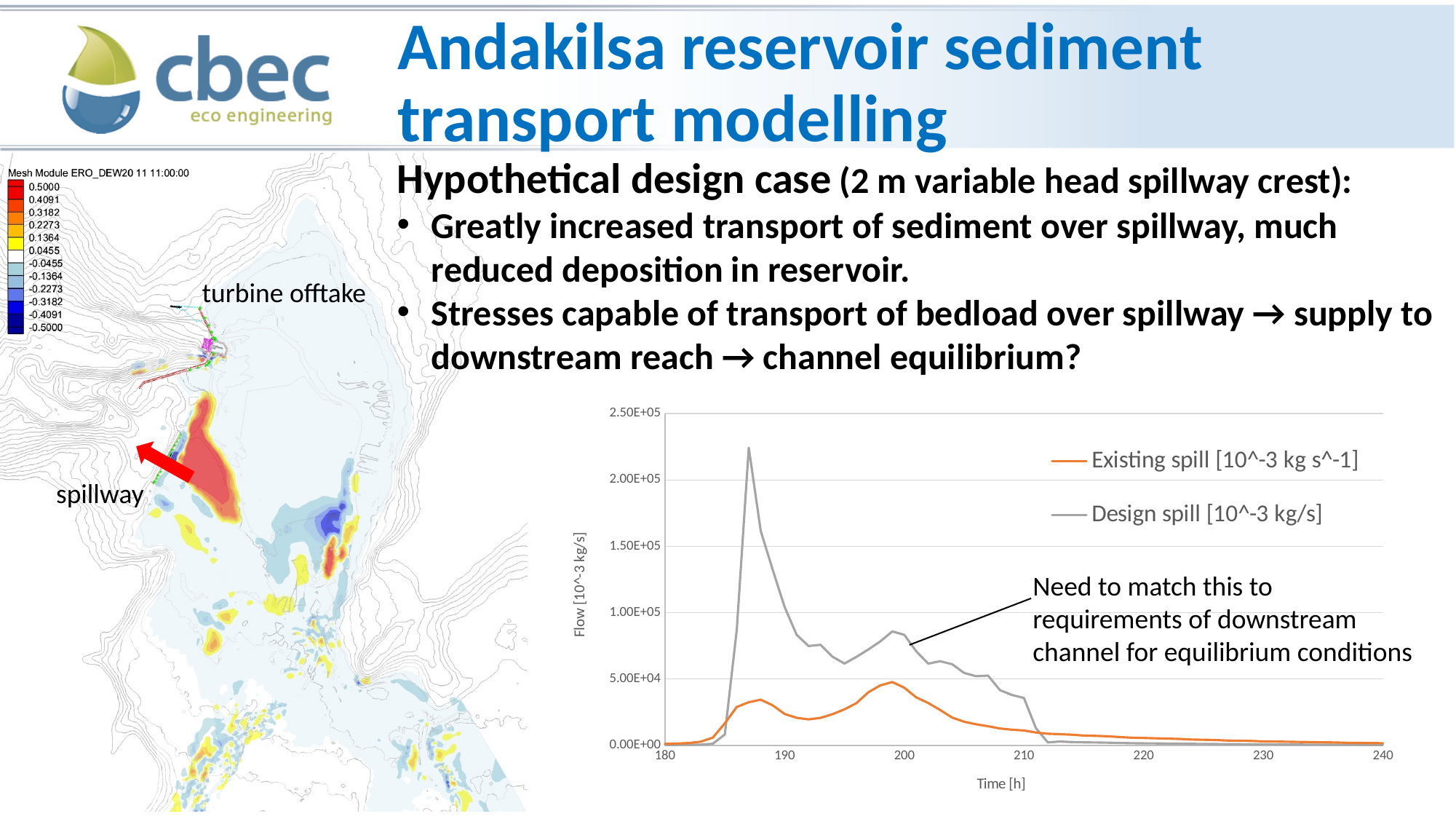
Is the Design spill value at time 220 h greater or less than 5.00E+04? less What is the highest value shown on the y axis of the flow chart? 2.50E+05 How many series does the legend of the flow chart list? 2 Which series is drawn in orange in the flow chart? Existing spill [10^-3 kg s^-1] What are the two series named in the legend of the flow chart? Existing spill [10^-3 kg s^-1] and Design spill [10^-3 kg/s] What kind of chart is shown on the right of the slide? line chart After its peak near 187 h, does the Design spill series generally rise or fall as time increases? fall Is the peak value of the Design spill series greater or less than 2.00E+05? greater Is the Design spill value at time 200 h greater or less than 5.00E+04? greater Which series reaches the higher peak value in the flow chart, Existing spill or Design spill? Design spill